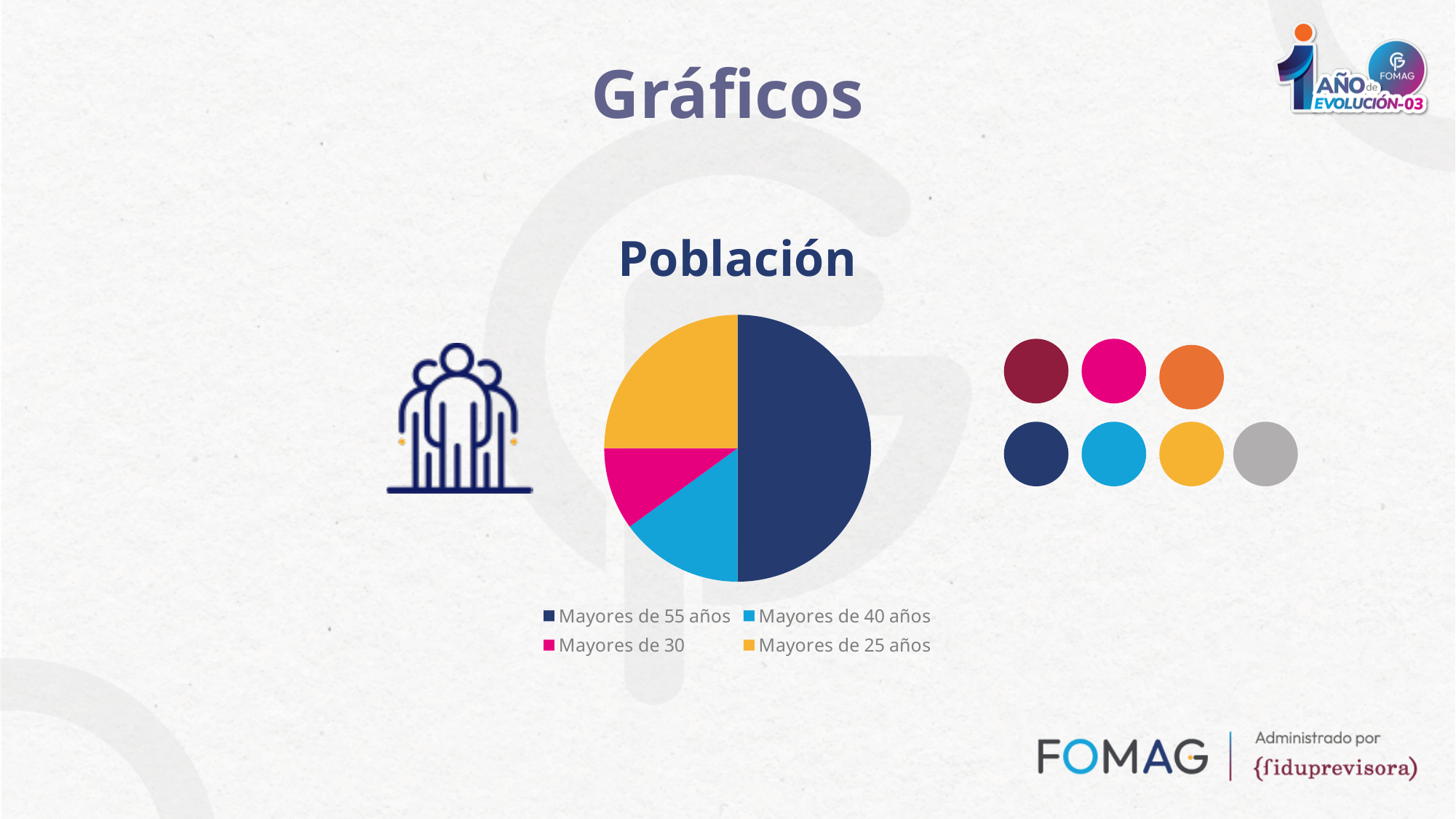
How many slices does the "Población" pie chart have? 4 In the "Población" pie chart, which slice is larger: Mayores de 30 or Mayores de 55 años? Mayores de 55 años Which category has the largest slice in the "Población" pie chart? Mayores de 55 años What kind of chart is shown under the title "Población"? pie chart What is the title of the pie chart on the slide? Población In the "Población" pie chart, which slice is larger: Mayores de 25 años or Mayores de 40 años? Mayores de 25 años What colour is the "Mayores de 25 años" slice in the "Población" pie chart? yellow How many entries does the legend of the "Población" chart list? 4 In the "Población" pie chart, which slice is larger: Mayores de 55 años or Mayores de 25 años? Mayores de 55 años